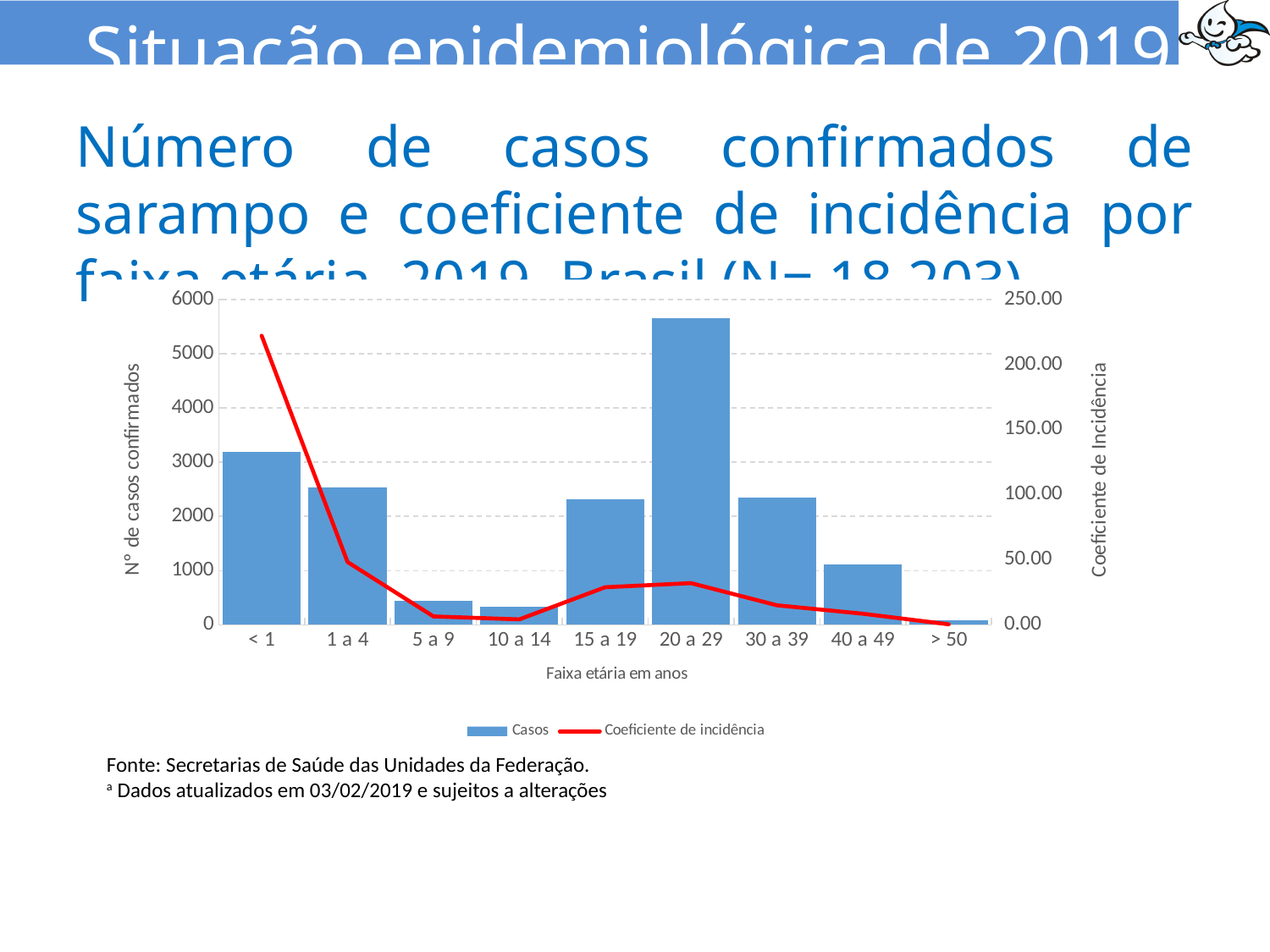
Which age group has the highest number of confirmed cases (Casos)? 20 a 29 Is the Coeficiente de incidência for the < 1 age group greater or less than 200.00? greater How many series does the legend list? 2 Which age group has the highest Coeficiente de incidência? < 1 What is the label of the x axis? Faixa etária em anos Is the number of cases for the < 1 age group greater or less than 3000? greater Which age group has more confirmed cases, < 1 or 1 a 4? < 1 Is the number of cases for the 20 a 29 age group greater or less than 5000? greater How many age groups are shown on the x axis? 9 Which age group has the lowest number of confirmed cases (Casos)? > 50